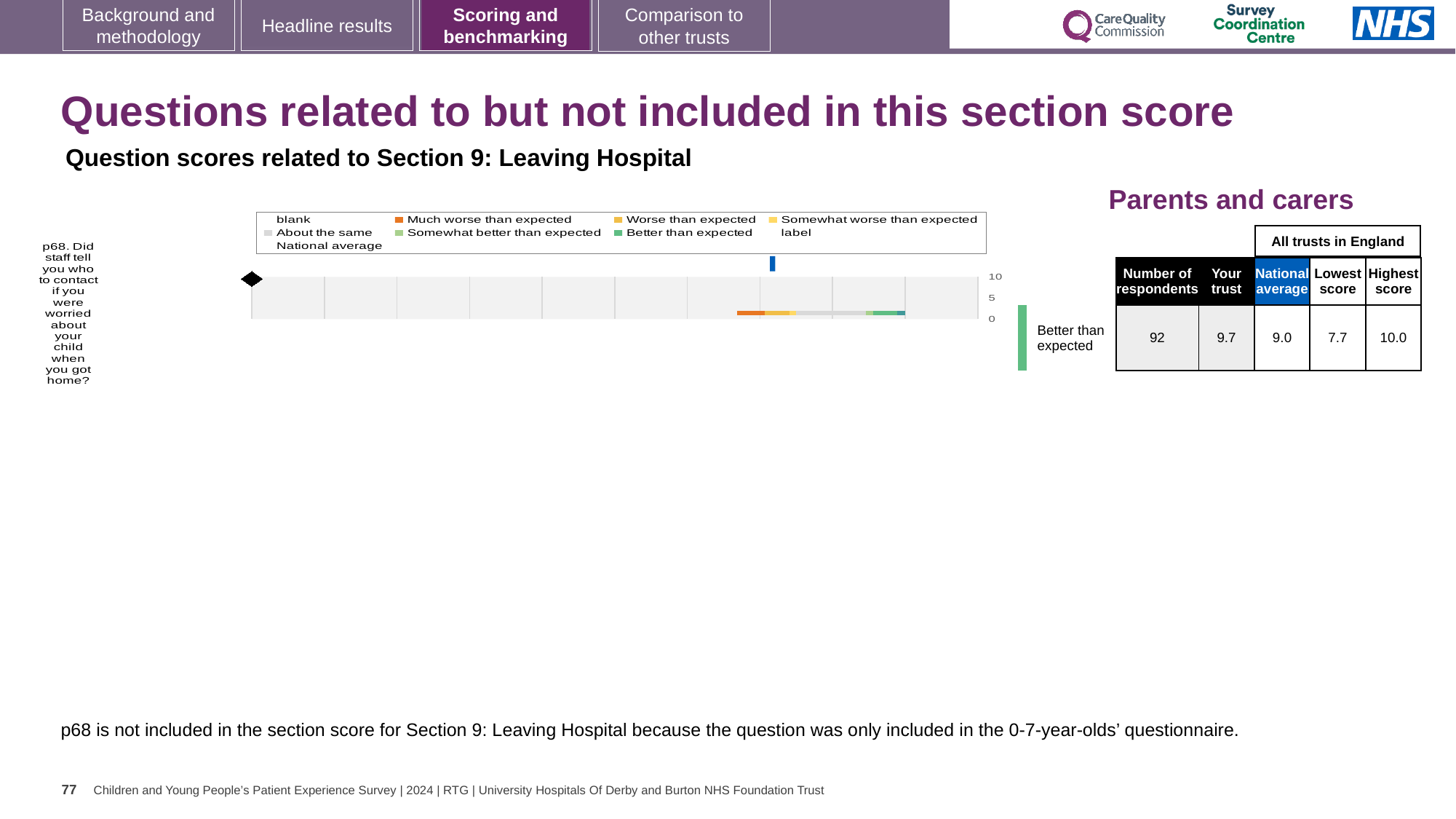
Which question is plotted in the chart? p68. Did staff tell you who to contact if you were worried about your child when you got home? What rating label is shown next to the chart for question p68? Better than expected How many entries does the chart legend list? 9 Which is larger for p68, the 'Your trust' score or the National average? Your trust In the table beside the chart, how many respondents answered p68? 92 In the table beside the chart, what is the Highest score across all trusts in England for p68? 10.0 How many questions are plotted in the chart? 1 What is the highest value shown on the chart's axis? 10 In the table beside the chart, what is the 'Your trust' score for p68? 9.7 In the table beside the chart, what is the Lowest score across all trusts in England for p68? 7.7 What kind of chart is shown on the slide? bar chart In the table beside the chart, what is the National average score for p68? 9.0